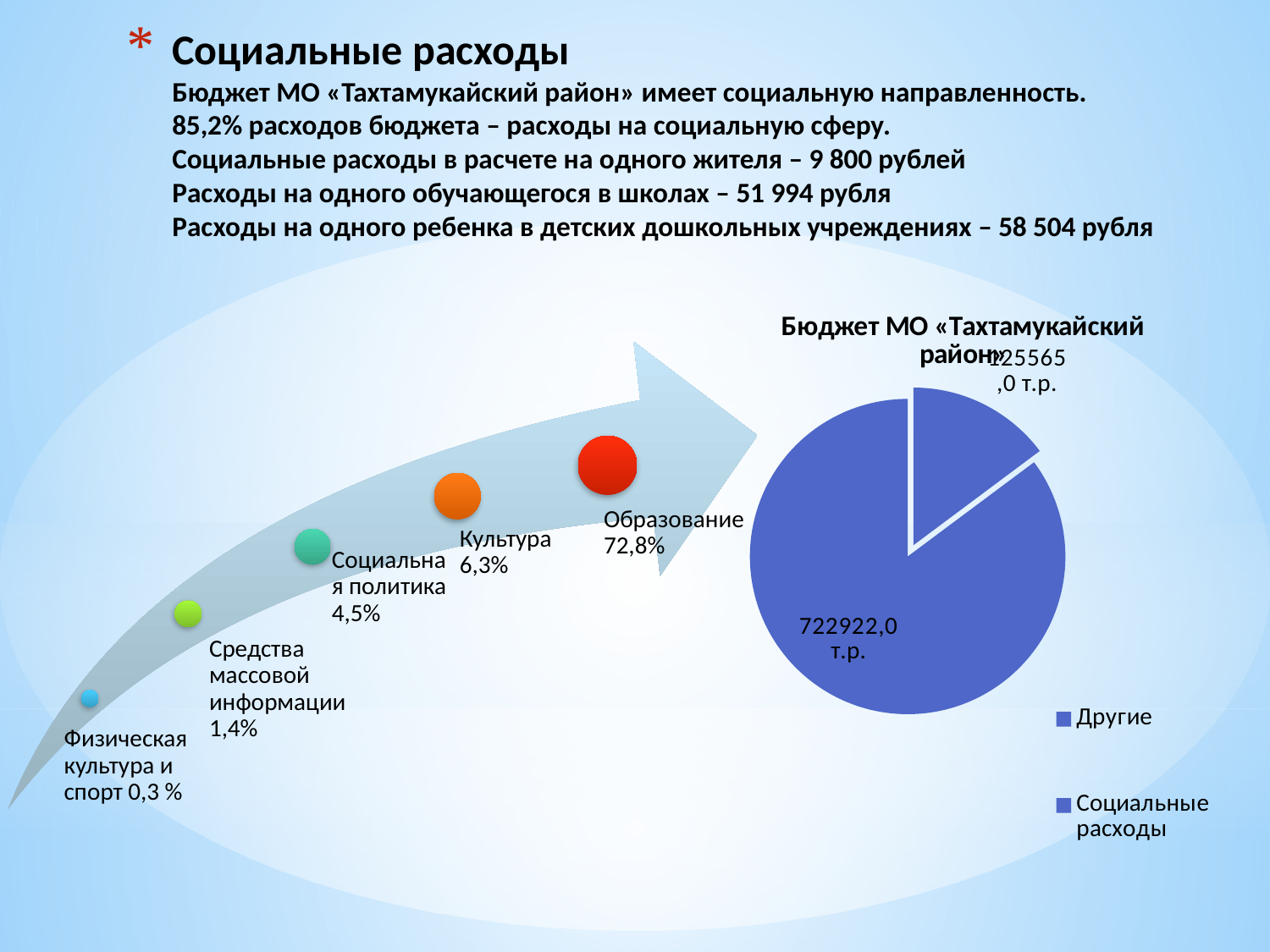
In the pie chart, what value is labelled on the large slice (Социальные расходы)? 722922,0 т.р. What kind of chart is shown on the right of the slide? pie chart Which category has the smallest slice in the pie chart? Другие What share of the pie chart does the Социальные расходы slice represent? 85,2% What is the title of the pie chart? Бюджет МО «Тахтамукайский район» In the pie chart, what is the difference between the Социальные расходы value and the Другие value? 597357,0 т.р. In the pie chart, which is larger: Социальные расходы or Другие? Социальные расходы How many entries does the legend of the pie chart list? 2 Which category has the largest slice in the pie chart? Социальные расходы In the pie chart, what value is labelled on the small slice (Другие)? 125565,0 т.р. What is the total of the two values shown in the pie chart? 848487,0 т.р. How many slices does the pie chart have? 2